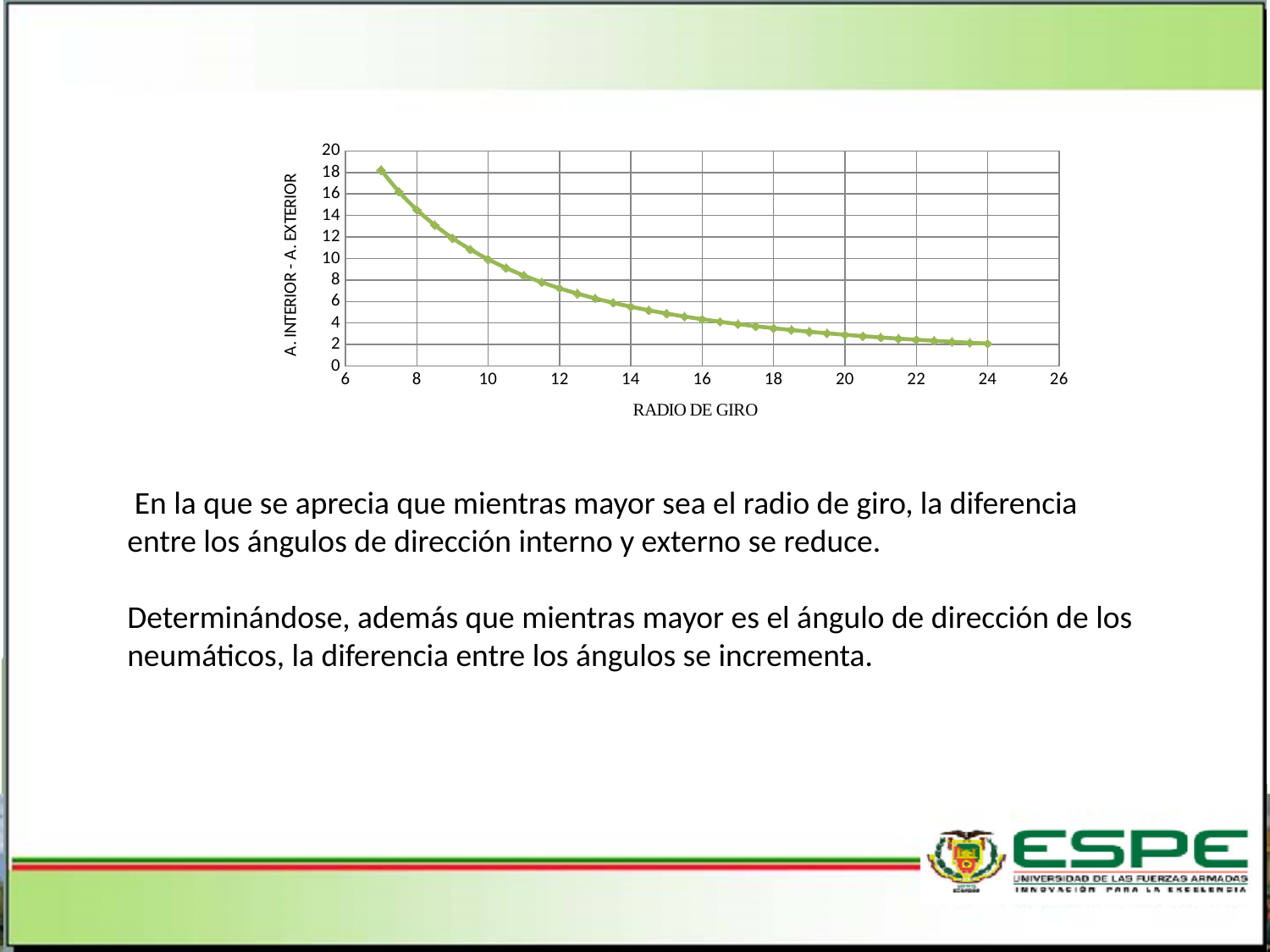
What is the title of the y axis? A. INTERIOR - A. EXTERIOR Is the value for RADIO DE GIRO 8 greater or less than 12? greater At which RADIO DE GIRO value is the plotted value lowest? 24 Is the value for RADIO DE GIRO 20 greater or less than 4? less Is the value for RADIO DE GIRO 14 greater or less than 8? less What is the title of the x axis? RADIO DE GIRO What kind of chart is shown on the slide? line chart Which is larger, the value at RADIO DE GIRO 10 or the value at RADIO DE GIRO 18? RADIO DE GIRO 10 Do the values rise or fall as RADIO DE GIRO increases along the x axis? fall At which RADIO DE GIRO value is the plotted value highest? 7